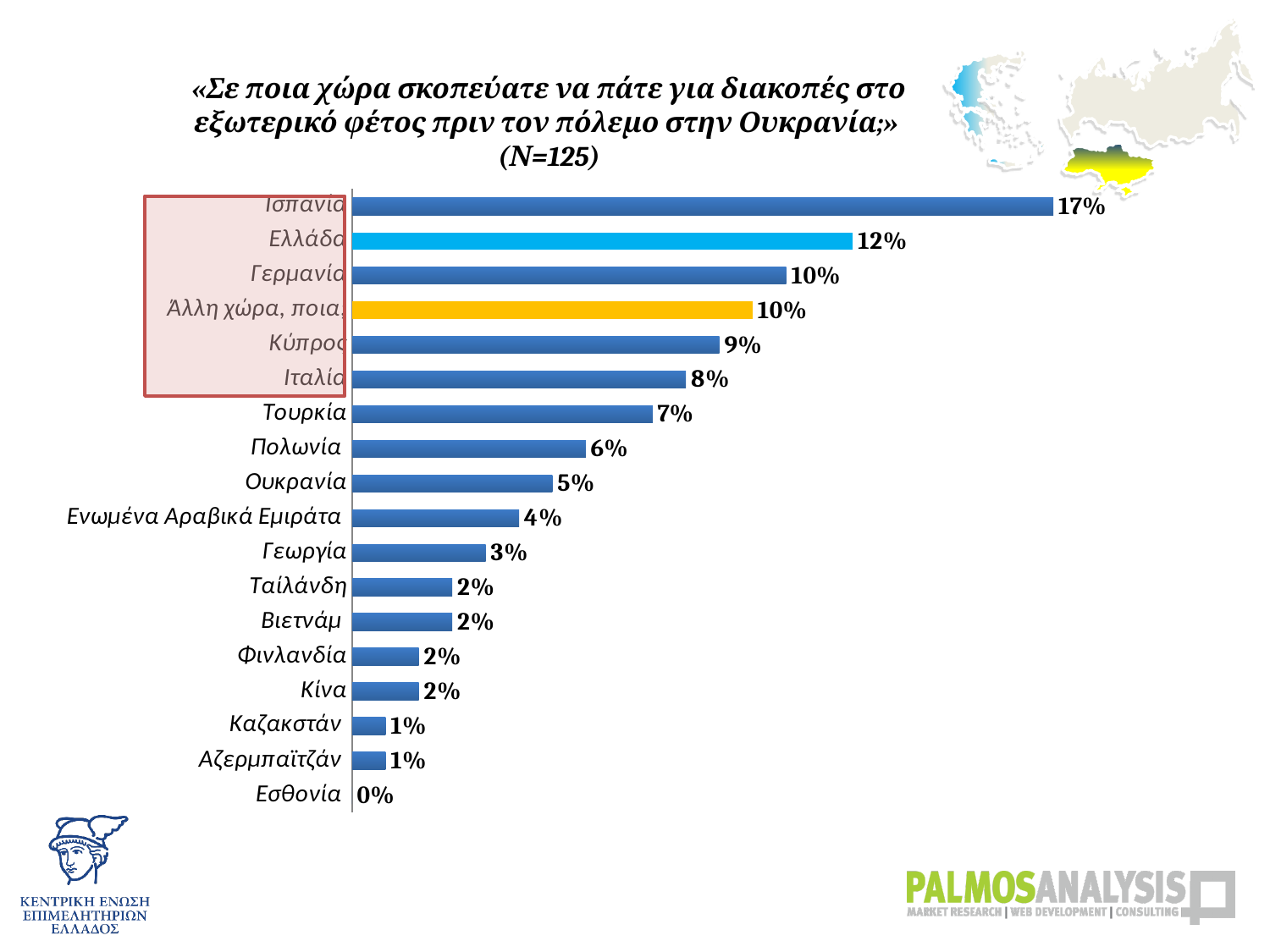
Which category has the lowest value? Εσθονία What is the value for Ισπανία? 17% What is the difference between the values for Ισπανία and Ελλάδα? 5% Which country has the highest value? Ισπανία What is the sample size (N) stated in the chart title? 125 What kind of chart is shown on the slide? Bar chart What is the value for Κύπρος? 9% What is the value for Ενωμένα Αραβικά Εμιράτα? 4% Which is larger, the value for Τουρκία or the value for Πολωνία? Τουρκία What is the value for Ελλάδα? 12% Which bar is coloured orange/yellow? Άλλη χώρα, ποια; How many categories are shown in the chart? 18